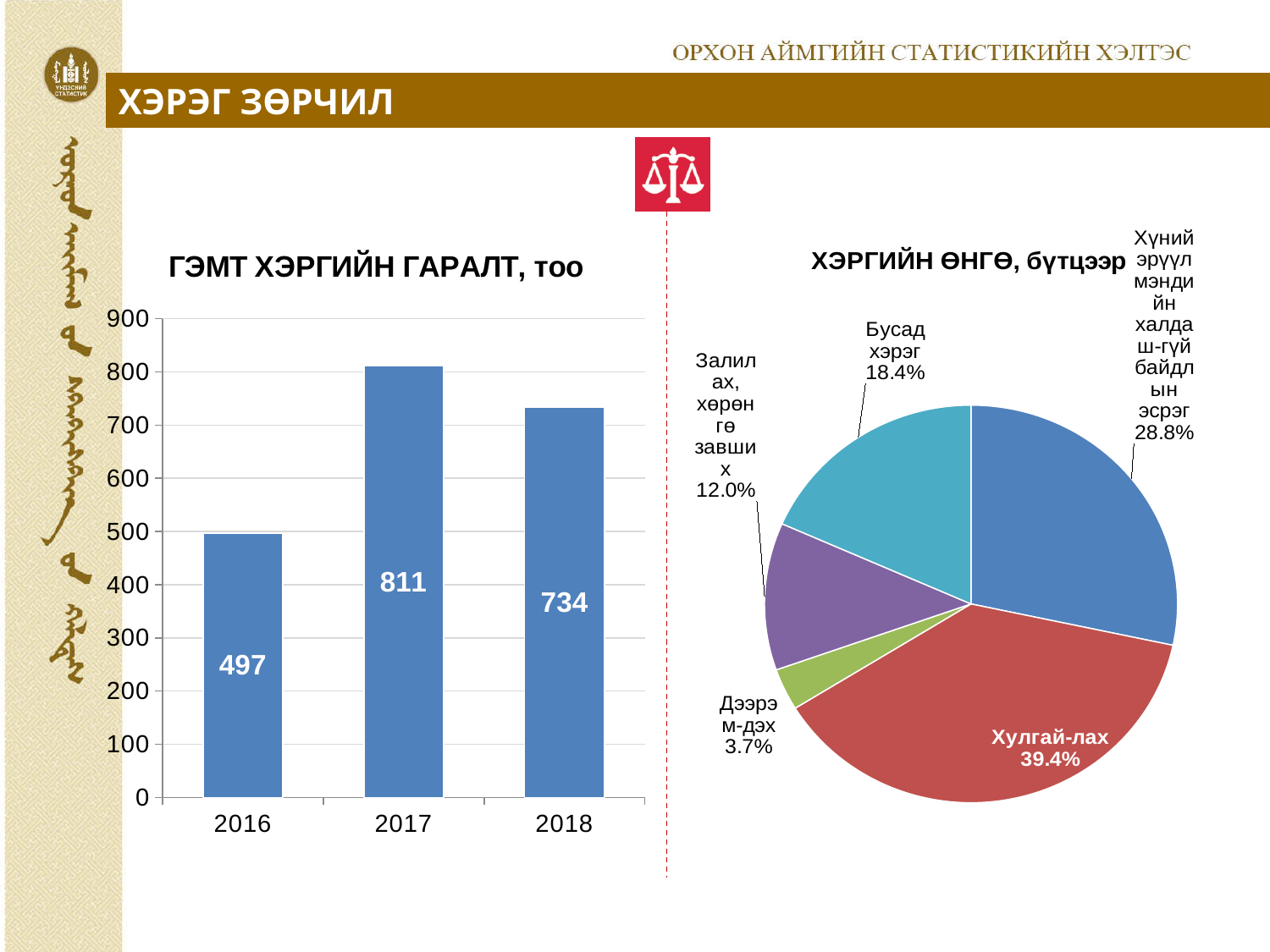
In the bar chart 'ГЭМТ ХЭРГИЙН ГАРАЛТ, тоо', which year has the lowest value? 2016 In the bar chart 'ГЭМТ ХЭРГИЙН ГАРАЛТ, тоо', what is the difference between the values for 2017 and 2018? 77 In the bar chart 'ГЭМТ ХЭРГИЙН ГАРАЛТ, тоо', what is the value for 2017? 811 In the bar chart 'ГЭМТ ХЭРГИЙН ГАРАЛТ, тоо', what is the value for 2016? 497 In the pie chart 'ХЭРГИЙН ӨНГӨ, бүтцээр', what share does 'Хулгайлах' have? 39.4% In the bar chart 'ГЭМТ ХЭРГИЙН ГАРАЛТ, тоо', how many years are shown on the x axis? 3 In the bar chart 'ГЭМТ ХЭРГИЙН ГАРАЛТ, тоо', which is larger, the value for 2016 or the value for 2018? 2018 In the pie chart 'ХЭРГИЙН ӨНГӨ, бүтцээр', what share does 'Бусад хэрэг' have? 18.4% In the pie chart 'ХЭРГИЙН ӨНГӨ, бүтцээр', which slice is the smallest? Дээрэмдэх What kind of chart is the left chart 'ГЭМТ ХЭРГИЙН ГАРАЛТ, тоо'? bar chart In the pie chart 'ХЭРГИЙН ӨНГӨ, бүтцээр', how many slices are there? 5 In the bar chart 'ГЭМТ ХЭРГИЙН ГАРАЛТ, тоо', which year has the highest value? 2017